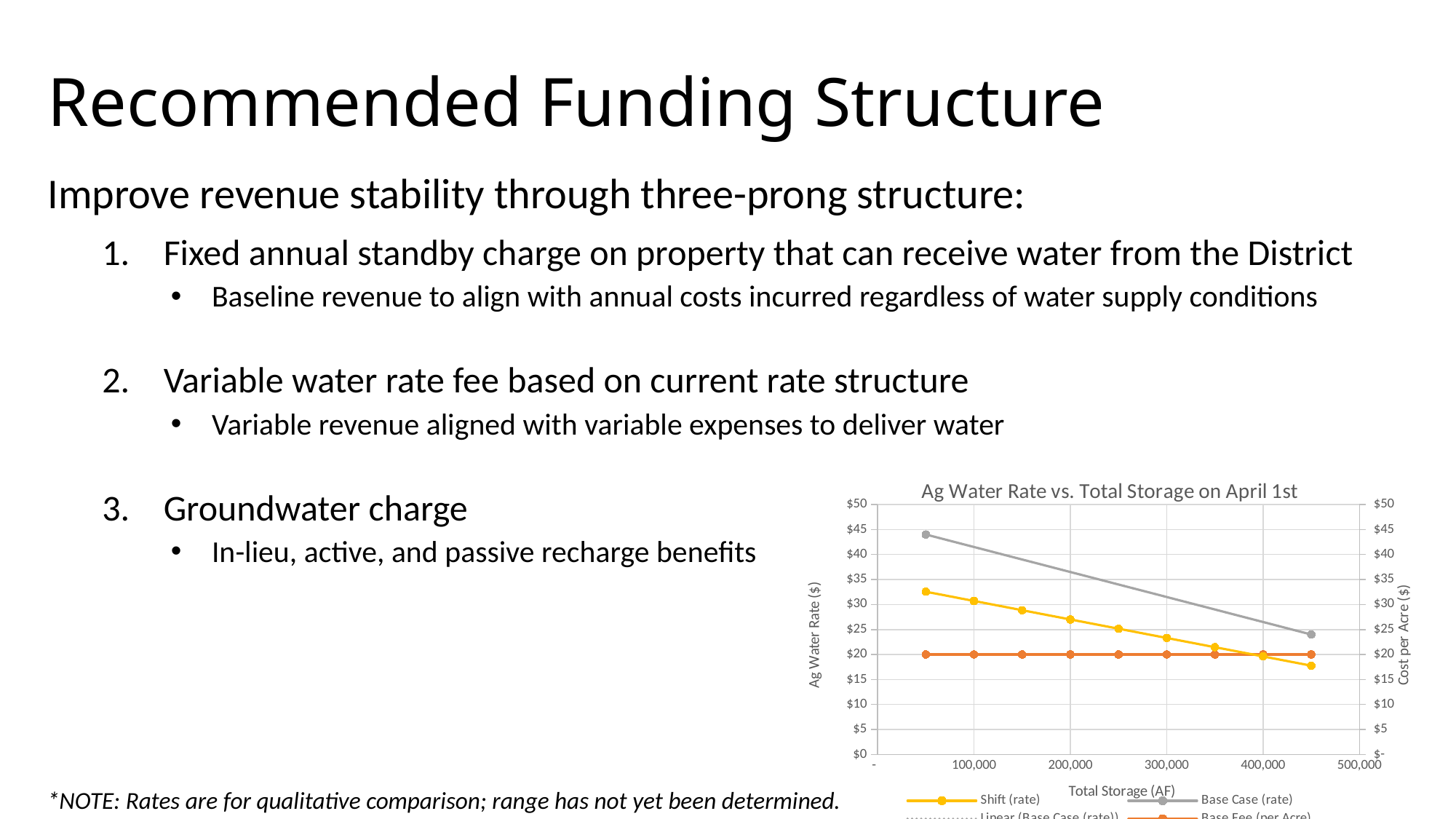
How many data points are plotted on the Shift (rate) series? 9 At 100,000 AF, which is higher: Base Case (rate) or Shift (rate)? Base Case (rate) Is the Base Case (rate) value at 450,000 AF greater or less than $20? greater Is the Base Case (rate) value at 50,000 AF greater or less than $40? greater Does the Base Fee (per Acre) series rise, fall, or stay flat as Total Storage increases? stay flat What is the value of the Base Fee (per Acre) series across the chart? $20 Does the Base Case (rate) series rise or fall as Total Storage increases? fall What is the title of the chart? Ag Water Rate vs. Total Storage on April 1st What kind of chart is shown on the slide? line chart What is the label of the x axis of the chart? Total Storage (AF) Is the Shift (rate) value at 450,000 AF greater or less than $20? less Does the Shift (rate) series rise or fall as Total Storage increases? fall